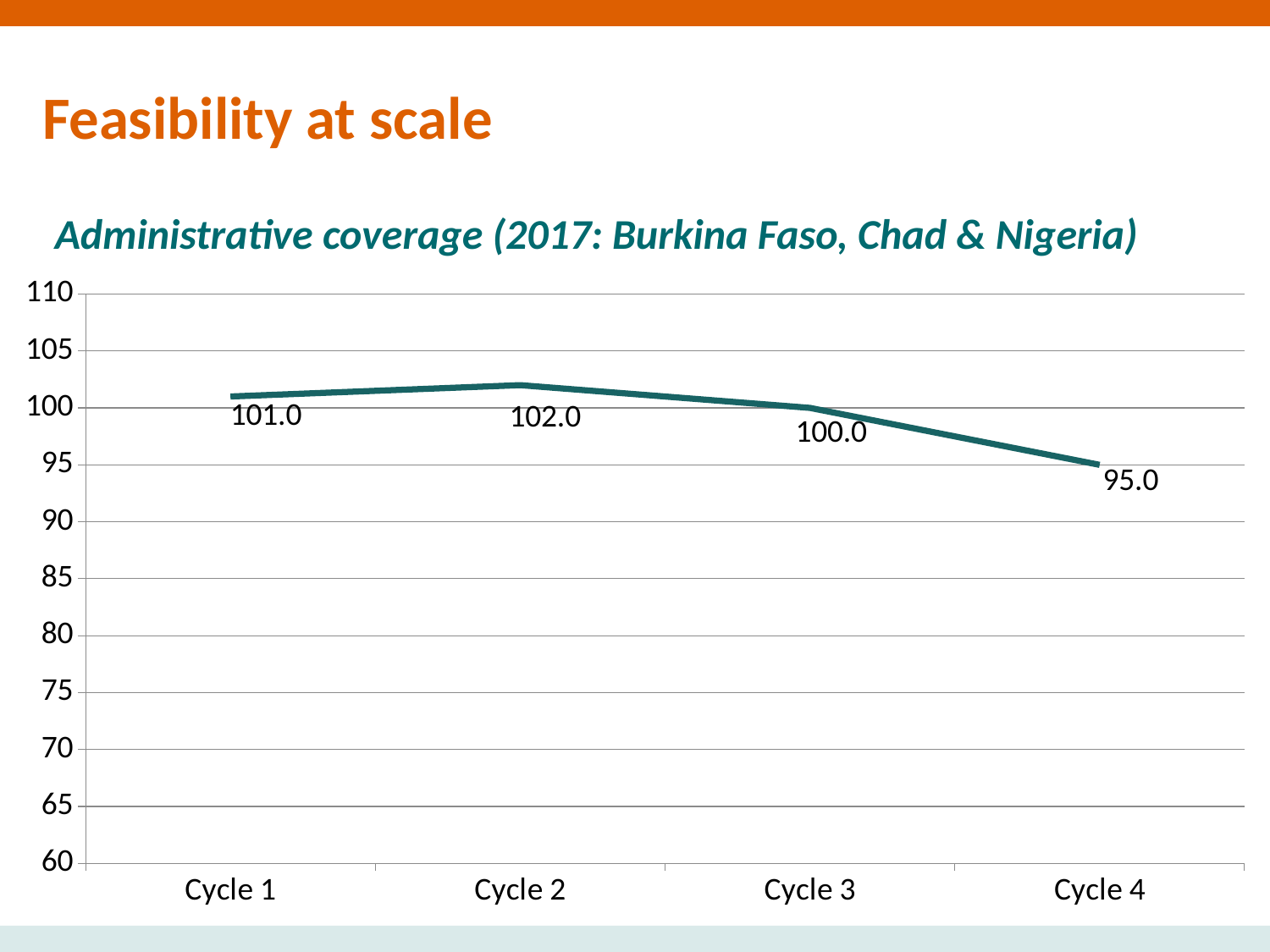
Which is larger, the value for Cycle 1 or the value for Cycle 3? Cycle 1 Which cycle has the lowest value? Cycle 4 What is the value for Cycle 1? 101.0 How many cycles are plotted on the chart? 4 What is the difference between the values for Cycle 2 and Cycle 4? 7.0 What is the value for Cycle 2? 102.0 What is the value for Cycle 4? 95.0 What kind of chart is shown on the slide? line chart Which cycle has the highest value? Cycle 2 What is the title of the chart? Administrative coverage (2017: Burkina Faso, Chad & Nigeria) Is the value for Cycle 4 greater or less than 100? less What is the value for Cycle 3? 100.0